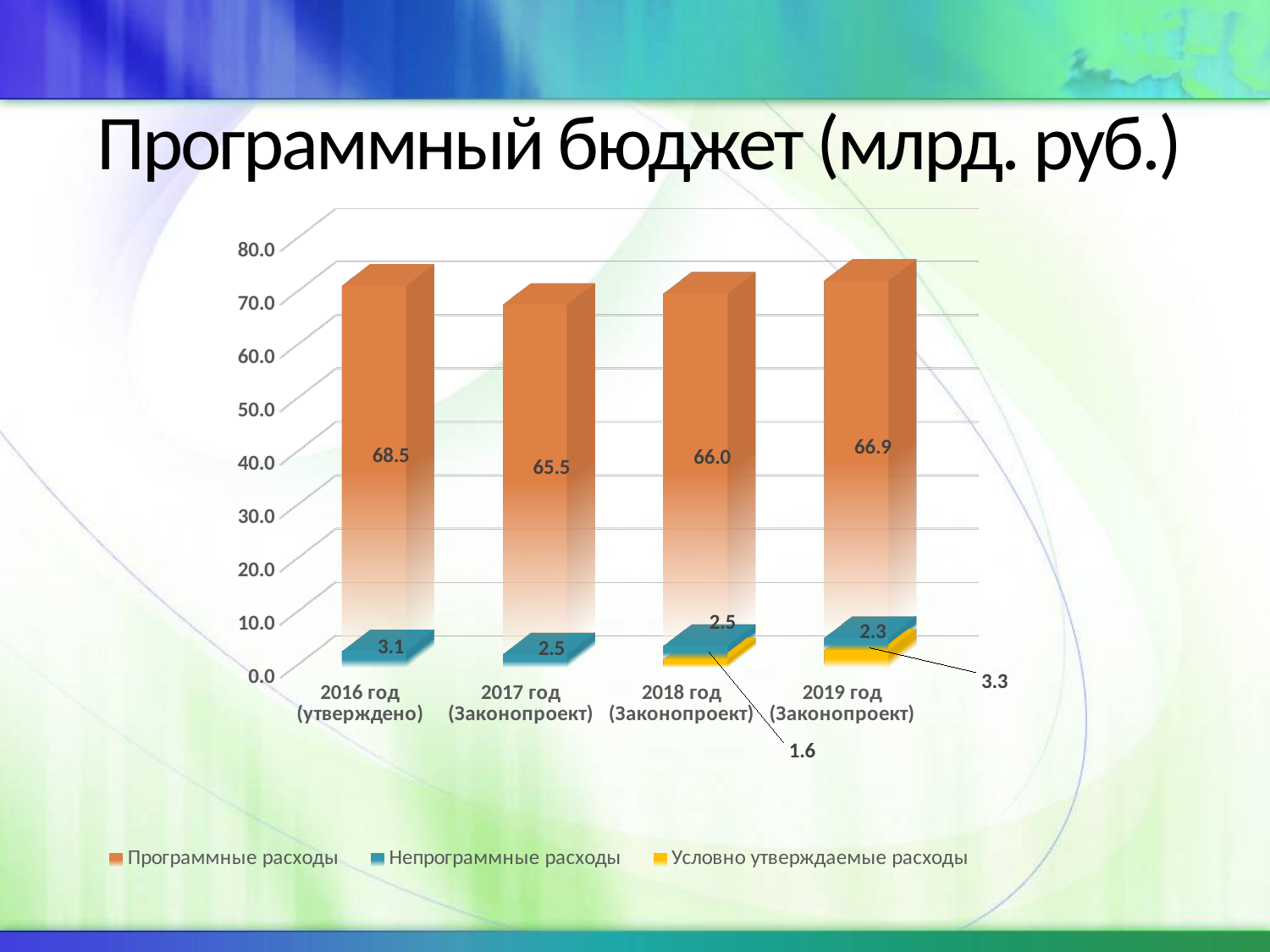
Which is larger: Непрограммные расходы in 2016 год (утверждено) or in 2019 год (Законопроект)? 2016 год (утверждено) What is the total of the stacked bar for 2019 год (Законопроект)? 72.5 How many year categories are shown on the x axis? 4 What is the value of Условно утверждаемые расходы for 2018 год (Законопроект)? 1.6 Which year has the lowest value of Программные расходы? 2017 год (Законопроект) How many series does the legend list? 3 What is the value of Условно утверждаемые расходы for 2019 год (Законопроект)? 3.3 What is the value of Непрограммные расходы for 2017 год (Законопроект)? 2.5 What is the value of Программные расходы for 2016 год (утверждено)? 68.5 What kind of chart is shown on the slide? Bar chart Which year has the highest value of Программные расходы? 2016 год (утверждено) What is the difference between Программные расходы in 2016 год (утверждено) and 2017 год (Законопроект)? 3.0